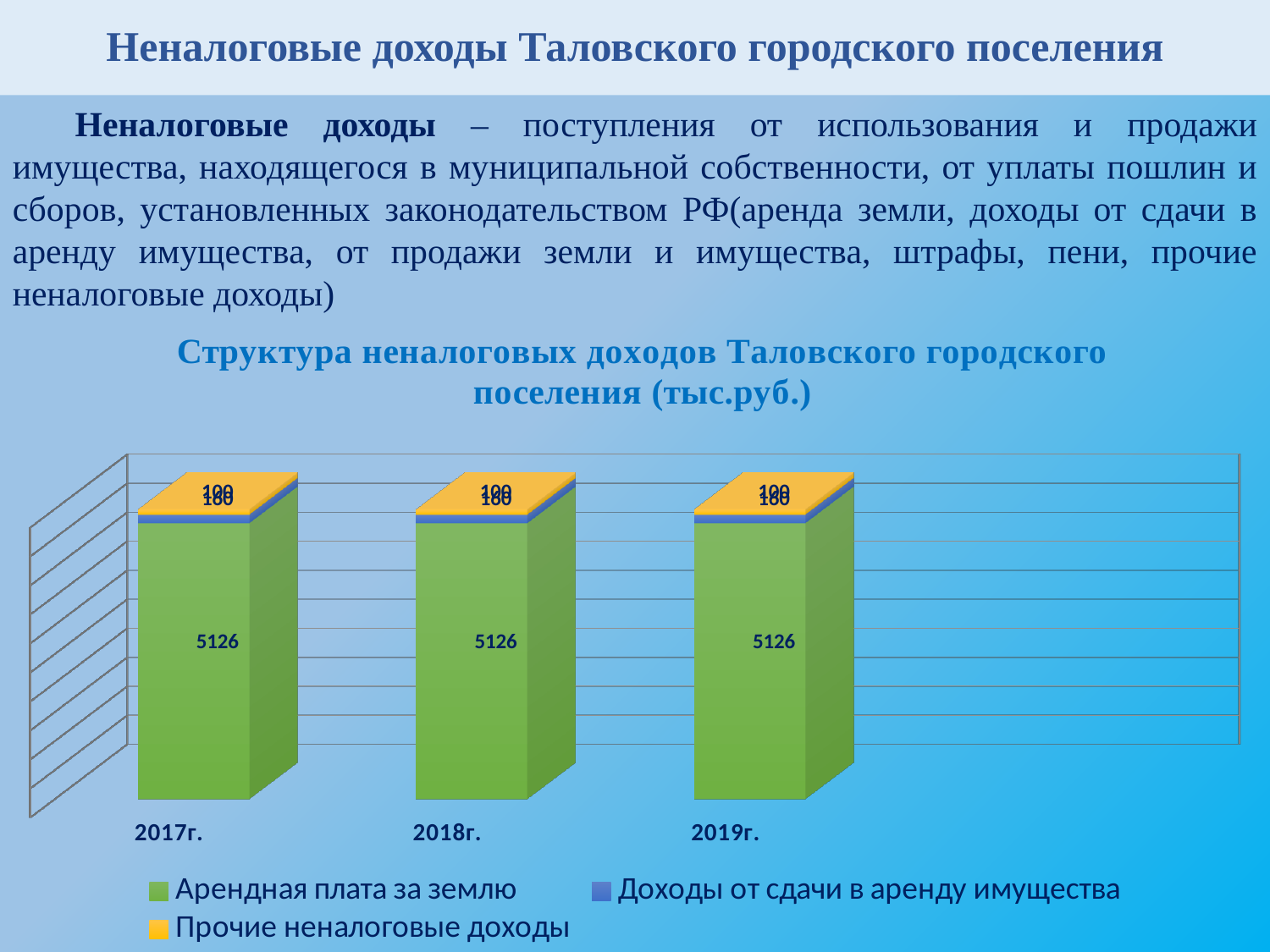
What is the value of Арендная плата за землю for 2017г.? 5126 What is the title of the chart? Структура неналоговых доходов Таловского городского поселения (тыс.руб.) Which series makes up the largest part of each stacked bar? Арендная плата за землю How many years (categories) are shown on the x axis of the chart? 3 What kind of chart is shown on the slide? Stacked bar chart How many series does the chart legend list? 3 Does the value of Арендная плата за землю rise, fall or stay the same from 2017г. to 2019г.? Stays the same Which series is shown in green in the chart? Арендная плата за землю What is the value of Арендная плата за землю for 2019г.? 5126 What is the difference between the Арендная плата за землю values for 2017г. and 2019г.? 0 What is the value of Арендная плата за землю for 2018г.? 5126